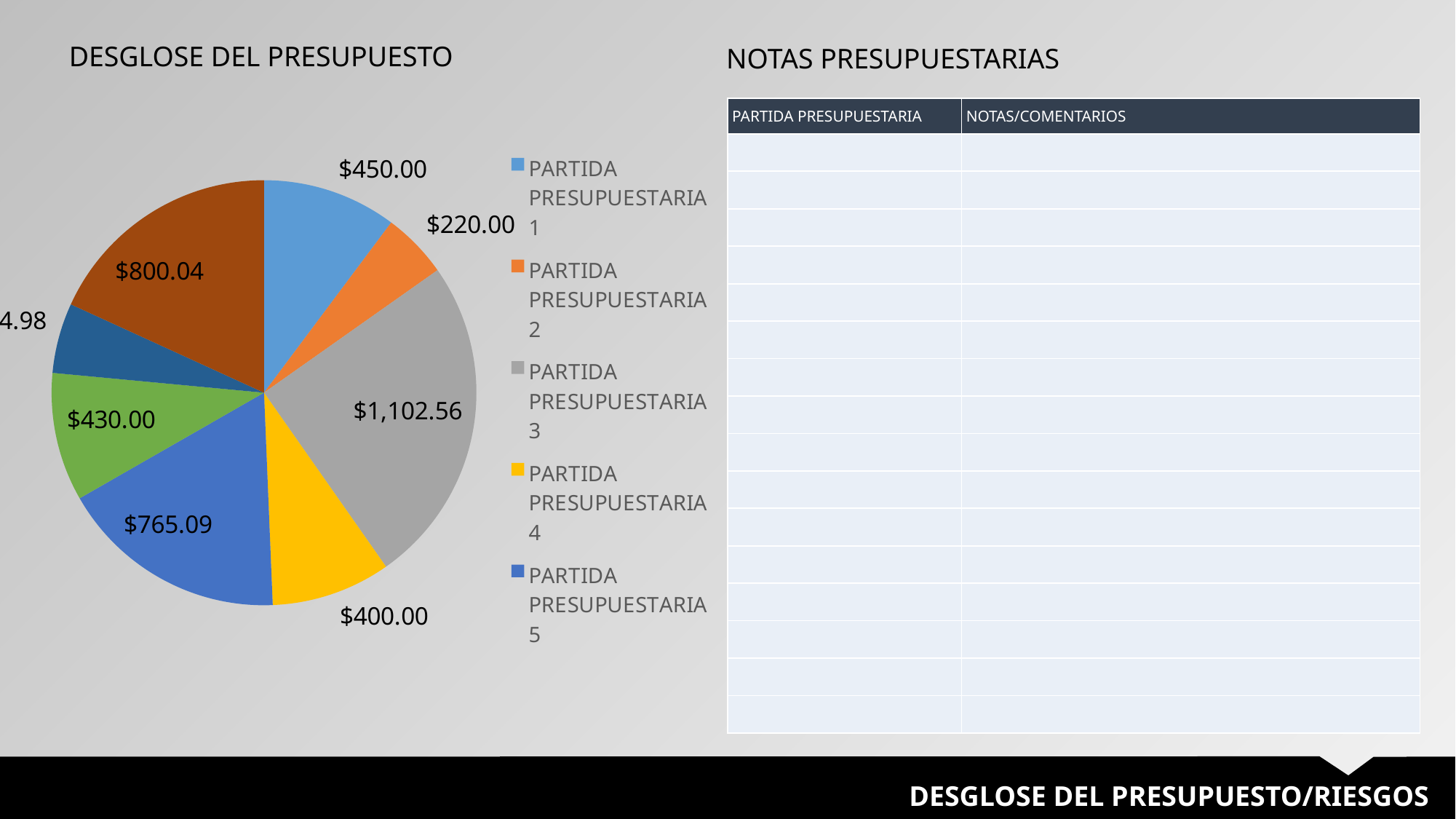
Which slice of the pie chart has the largest value? PARTIDA PRESUPUESTARIA 3 What is the value of PARTIDA PRESUPUESTARIA 5 in the pie chart? $765.09 What is the title of the pie chart? DESGLOSE DEL PRESUPUESTO What type of chart is shown under the title DESGLOSE DEL PRESUPUESTO? Pie chart What is the value of PARTIDA PRESUPUESTARIA 1 in the pie chart? $450.00 Which is larger, the value of PARTIDA PRESUPUESTARIA 1 or PARTIDA PRESUPUESTARIA 4? PARTIDA PRESUPUESTARIA 1 What is the value of PARTIDA PRESUPUESTARIA 4 in the pie chart? $400.00 What is the value of PARTIDA PRESUPUESTARIA 3 in the pie chart? $1,102.56 What is the difference between the values of PARTIDA PRESUPUESTARIA 1 and PARTIDA PRESUPUESTARIA 2? $230.00 What is the difference between the values of PARTIDA PRESUPUESTARIA 5 and PARTIDA PRESUPUESTARIA 4? $365.09 What is the value of PARTIDA PRESUPUESTARIA 2 in the pie chart? $220.00 How many entries does the legend of the pie chart list? 5